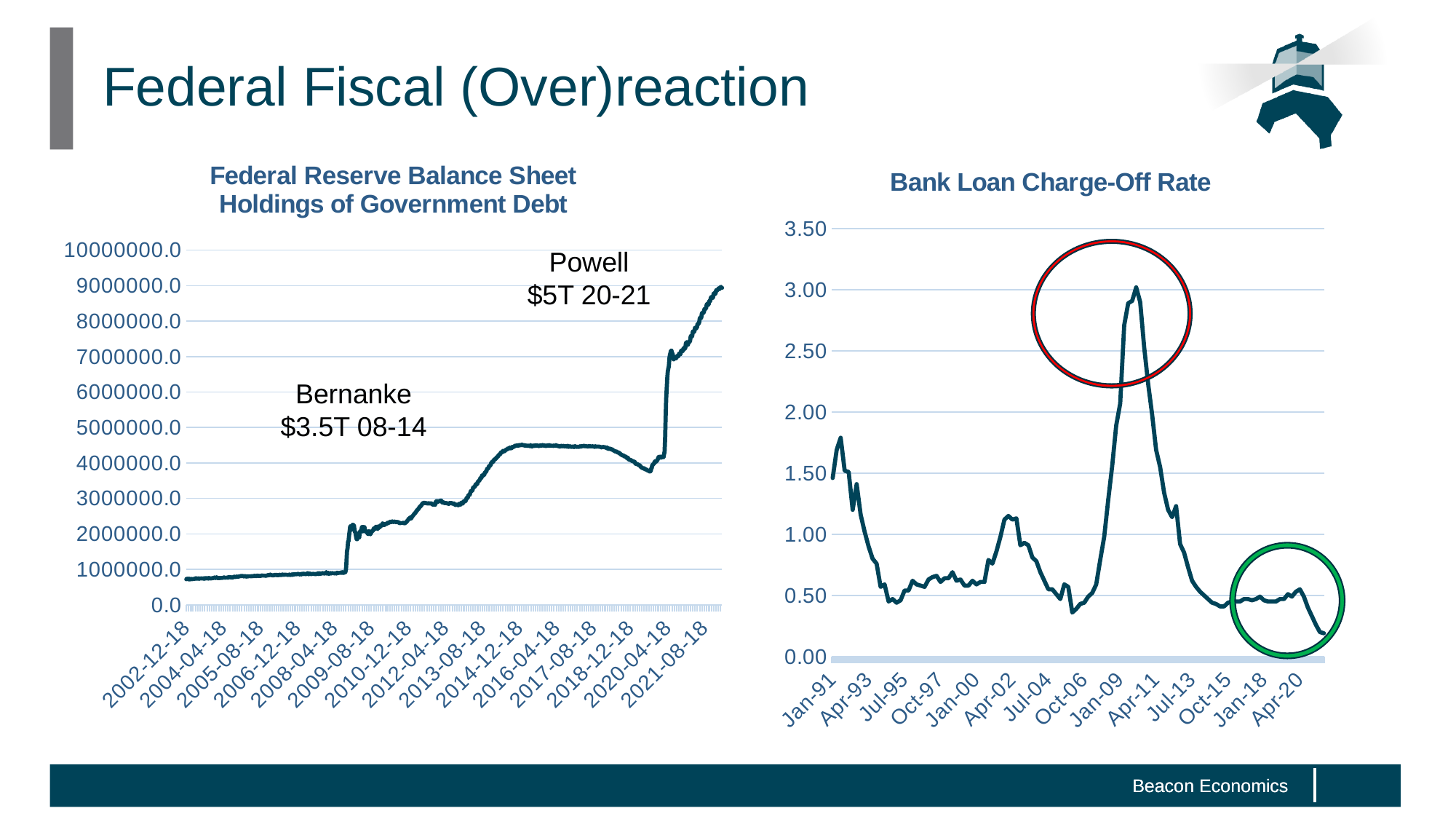
In the 'Bank Loan Charge-Off Rate' chart, is the peak value greater or less than 2.50? greater In the 'Federal Reserve Balance Sheet Holdings of Government Debt' chart, is the value at 2002-12-18 greater or less than 1000000.0? less In the 'Bank Loan Charge-Off Rate' chart, is the value at Oct-15 greater or less than 1.00? less In the 'Federal Reserve Balance Sheet Holdings of Government Debt' chart, what amount is annotated next to the Bernanke label? $3.5T 08-14 In the 'Federal Reserve Balance Sheet Holdings of Government Debt' chart, which is larger: the value at 2021-08-18 or the value at 2016-04-18? 2021-08-18 In the 'Bank Loan Charge-Off Rate' chart, what colour is the circle drawn around the peak of the line? red In the 'Federal Reserve Balance Sheet Holdings of Government Debt' chart, what amount is annotated next to the Powell label? $5T 20-21 What type of chart is the 'Federal Reserve Balance Sheet Holdings of Government Debt' chart? line chart What type of chart is the 'Bank Loan Charge-Off Rate' chart? line chart In the 'Federal Reserve Balance Sheet Holdings of Government Debt' chart, do the values generally rise or fall from 2002-12-18 to 2021-08-18? rise